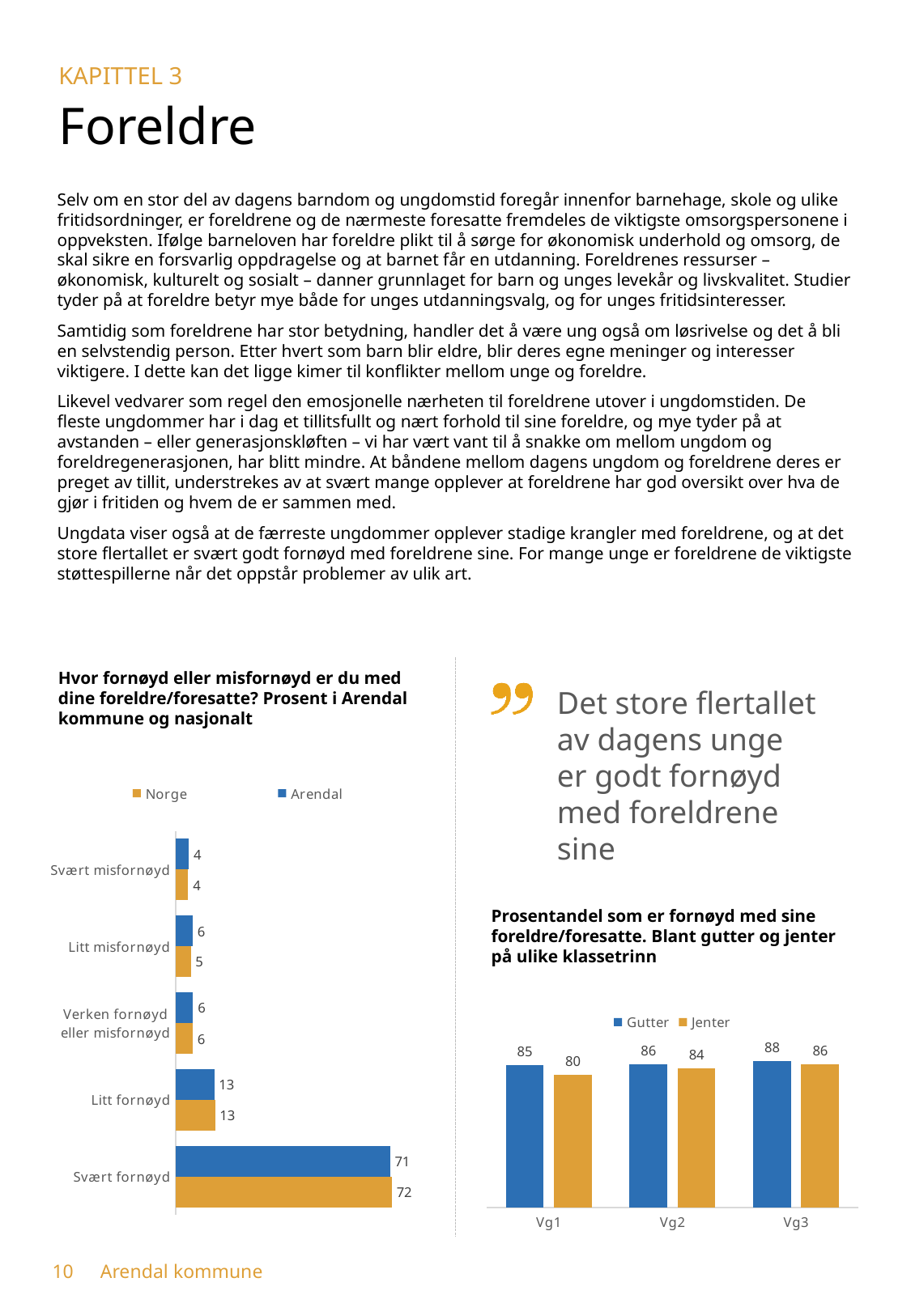
In the left chart (Hvor fornøyd eller misfornøyd er du med dine foreldre/foresatte?), what type of chart is used? Bar chart In the right chart (Prosentandel som er fornøyd med sine foreldre/foresatte), what is the Jenter value for Vg1? 80 In the left chart (Hvor fornøyd eller misfornøyd er du med dine foreldre/foresatte?), what is the Arendal value for Svært fornøyd? 71 In the right chart (Prosentandel som er fornøyd med sine foreldre/foresatte), what is the difference between Gutter and Jenter for Vg1? 5 In the right chart (Prosentandel som er fornøyd med sine foreldre/foresatte), what is the Gutter value for Vg3? 88 In the left chart (Hvor fornøyd eller misfornøyd er du med dine foreldre/foresatte?), what is the Norge value for Litt misfornøyd? 5 In the right chart (Prosentandel som er fornøyd med sine foreldre/foresatte), how many series does the legend list? 2 In the left chart (Hvor fornøyd eller misfornøyd er du med dine foreldre/foresatte?), what is the Norge value for Svært fornøyd? 72 In the left chart (Hvor fornøyd eller misfornøyd er du med dine foreldre/foresatte?), which category has the highest Arendal value? Svært fornøyd In the left chart (Hvor fornøyd eller misfornøyd er du med dine foreldre/foresatte?), what is the difference between the Arendal and Norge values for Litt misfornøyd? 1 In the right chart (Prosentandel som er fornøyd med sine foreldre/foresatte), do the Jenter values rise or fall from Vg1 to Vg3? Rise In the left chart (Hvor fornøyd eller misfornøyd er du med dine foreldre/foresatte?), how many categories are shown? 5